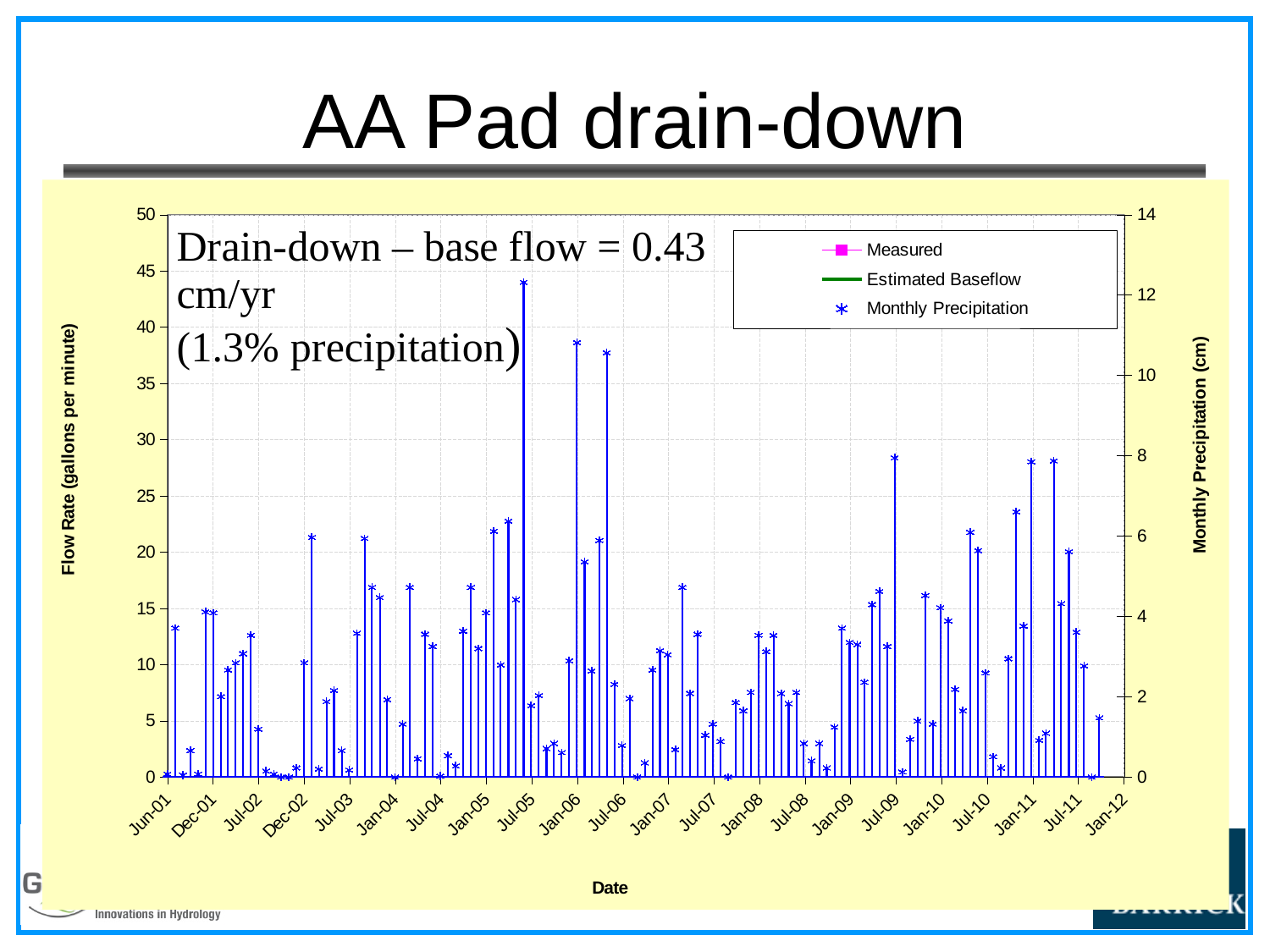
What is the title of the left vertical axis? Flow Rate (gallons per minute) Is the highest monthly precipitation spike (near Jul-05) greater or less than 10 cm on the right axis? greater What is the maximum value shown on the left-hand flow rate axis? 50 According to the annotation on the chart, what is the drain-down base flow in cm/yr? 0.43 cm/yr Is the monthly precipitation spike near Jul-09 greater or less than 6 cm on the right axis? greater Is the monthly precipitation spike near Jan-06 greater or less than 8 cm on the right axis? greater What is the maximum value shown on the right-hand precipitation axis? 14 Near which x-axis date label does the highest monthly precipitation spike occur? Jul-05 What are the three series named in the chart legend? Measured, Estimated Baseflow, Monthly Precipitation What is the title of the right vertical axis? Monthly Precipitation (cm) How many series does the chart legend list? 3 According to the annotation on the chart, what percentage of precipitation does the base flow represent? 1.3%